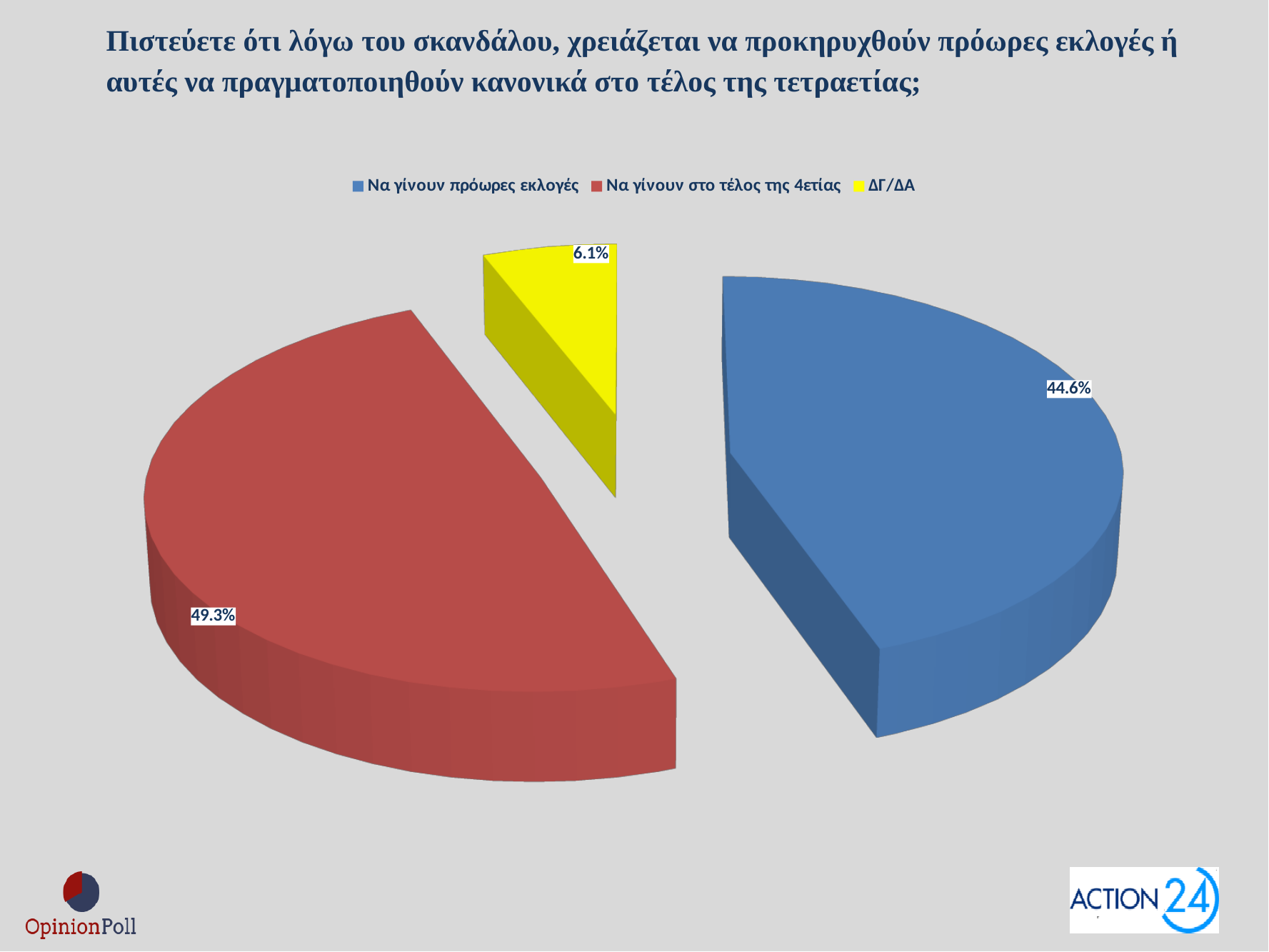
What percentage of respondents answered "Να γίνουν πρόωρες εκλογές"? 44.6% What colour is the slice for "Να γίνουν πρόωρες εκλογές"? Blue Which response has the smallest share of the pie? ΔΓ/ΔΑ What percentage of respondents answered "Να γίνουν στο τέλος της 4ετίας"? 49.3% How many entries does the legend list? 3 Which response has the largest share of the pie? Να γίνουν στο τέλος της 4ετίας Which is larger: the share for "Να γίνουν πρόωρες εκλογές" or the share for "ΔΓ/ΔΑ"? Να γίνουν πρόωρες εκλογές What is the difference in percentage points between "Να γίνουν στο τέλος της 4ετίας" and "Να γίνουν πρόωρες εκλογές"? 4.7 What type of chart is shown on the slide? Pie chart How many slices does the pie chart have? 3 What colour is the slice for "ΔΓ/ΔΑ"? Yellow What percentage of respondents answered "ΔΓ/ΔΑ"? 6.1%